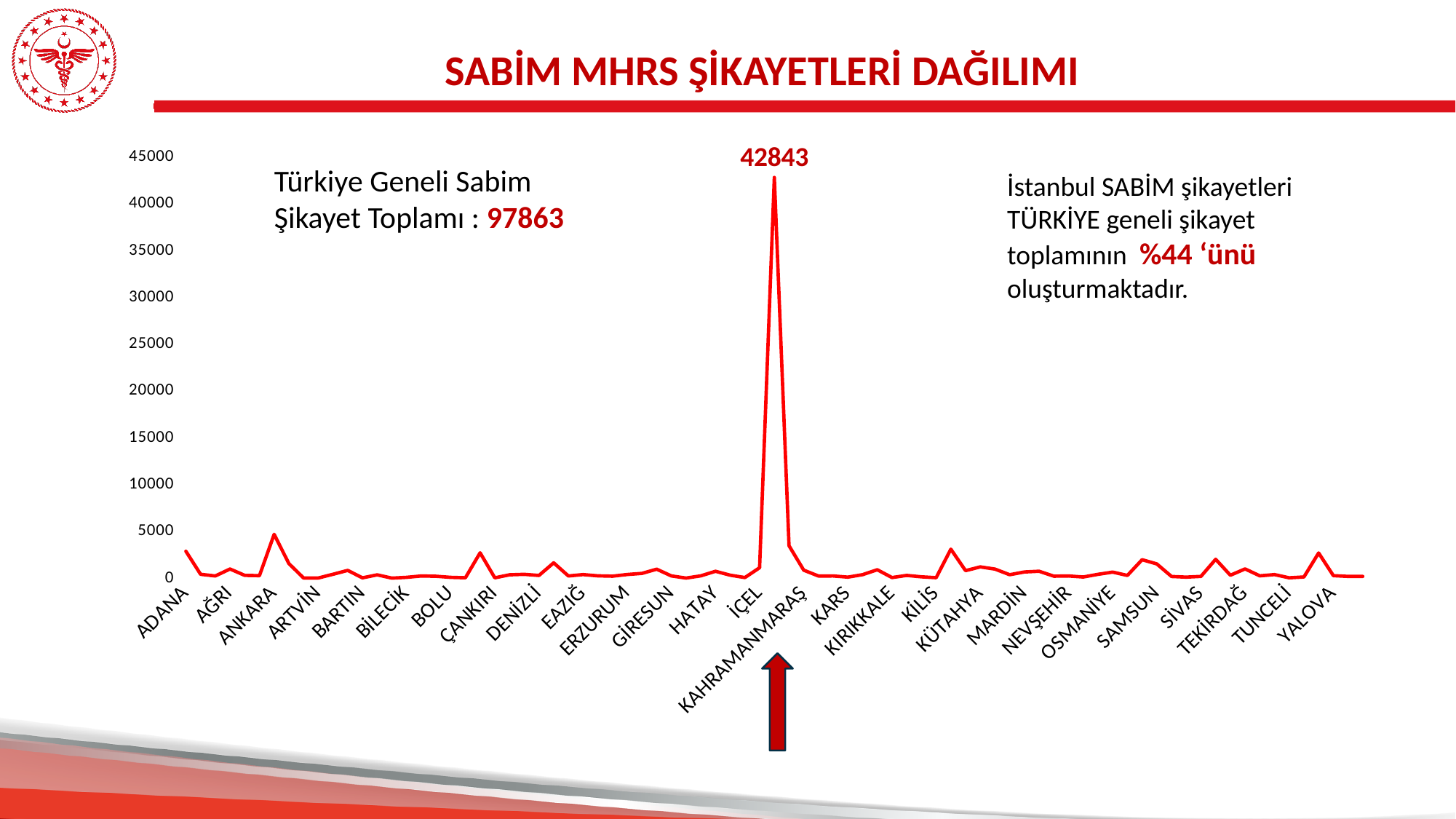
Is the value for ANKARA greater or less than 10000? less What kind of chart is shown on the slide? line chart Is the value for KÜTAHYA greater or less than 5000? less What is the value printed at the peak of the line? 42843 What is the highest tick value shown on the vertical axis? 45000 Is the value for ADANA greater or less than 5000? less What is the Türkiye-wide total of SABİM complaints stated on the slide? 97863 Which province has the highest number of SABİM complaints? İstanbul Which has a higher value, ANKARA or ADANA? ANKARA Which has a higher value, ANKARA or ÇANKIRI? ANKARA What is the title of the slide's chart? SABİM MHRS ŞİKAYETLERİ DAĞILIMI What share of the Türkiye-wide complaint total do İstanbul's SABİM complaints make up? %44